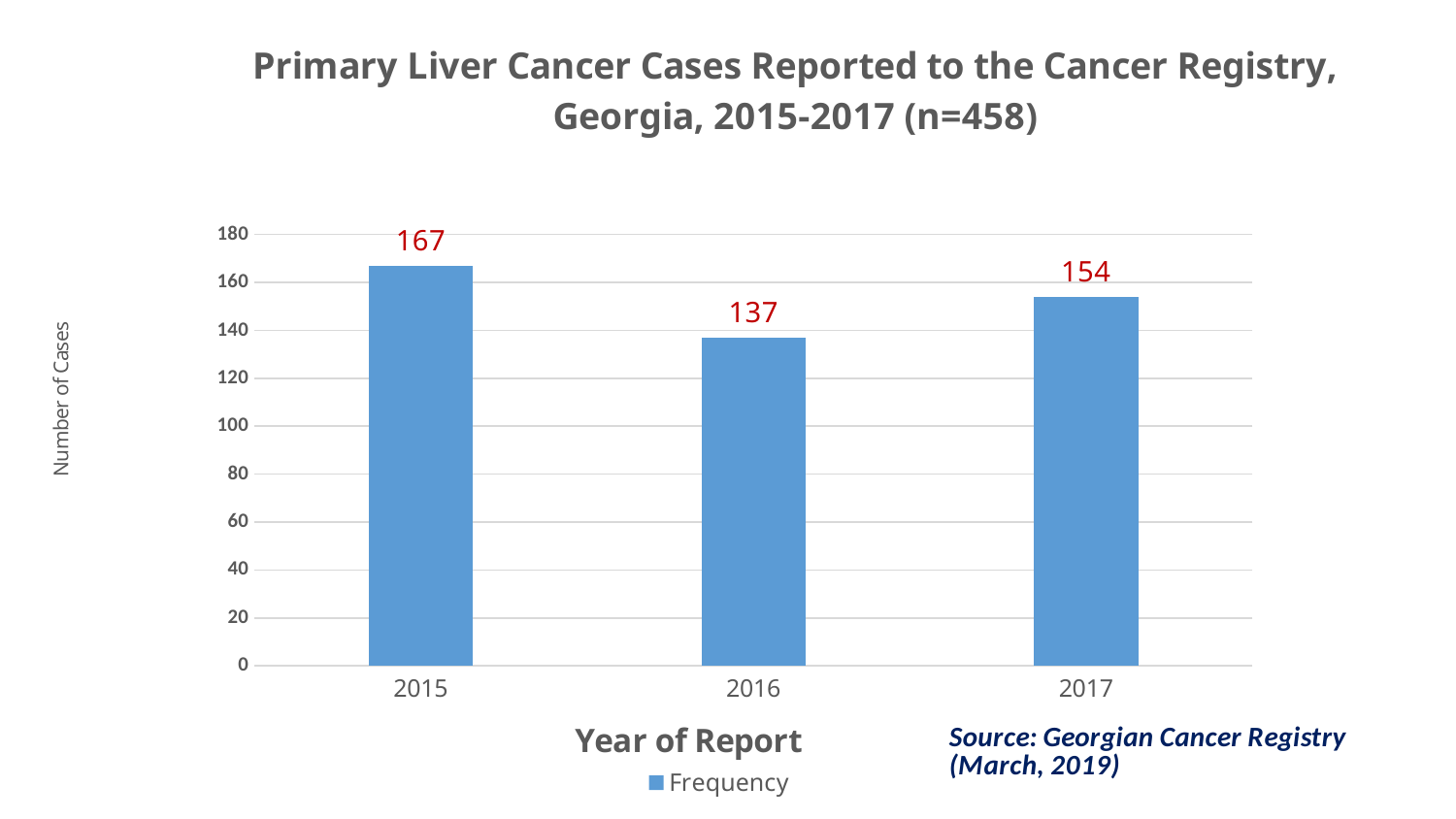
Which year has the highest number of cases? 2015 What is the label of the y axis? Number of Cases What kind of chart is shown on the slide? bar chart What is the number of cases reported in 2016? 137 How many years are shown on the x axis? 3 Is the value for 2016 greater or less than 140? less What is the value for 2017? 154 Which year has the lowest number of cases? 2016 What is the difference in cases between 2015 and 2016? 30 Which year had more cases, 2016 or 2017? 2017 What is the difference in cases between 2017 and 2016? 17 How many primary liver cancer cases were reported in 2015? 167